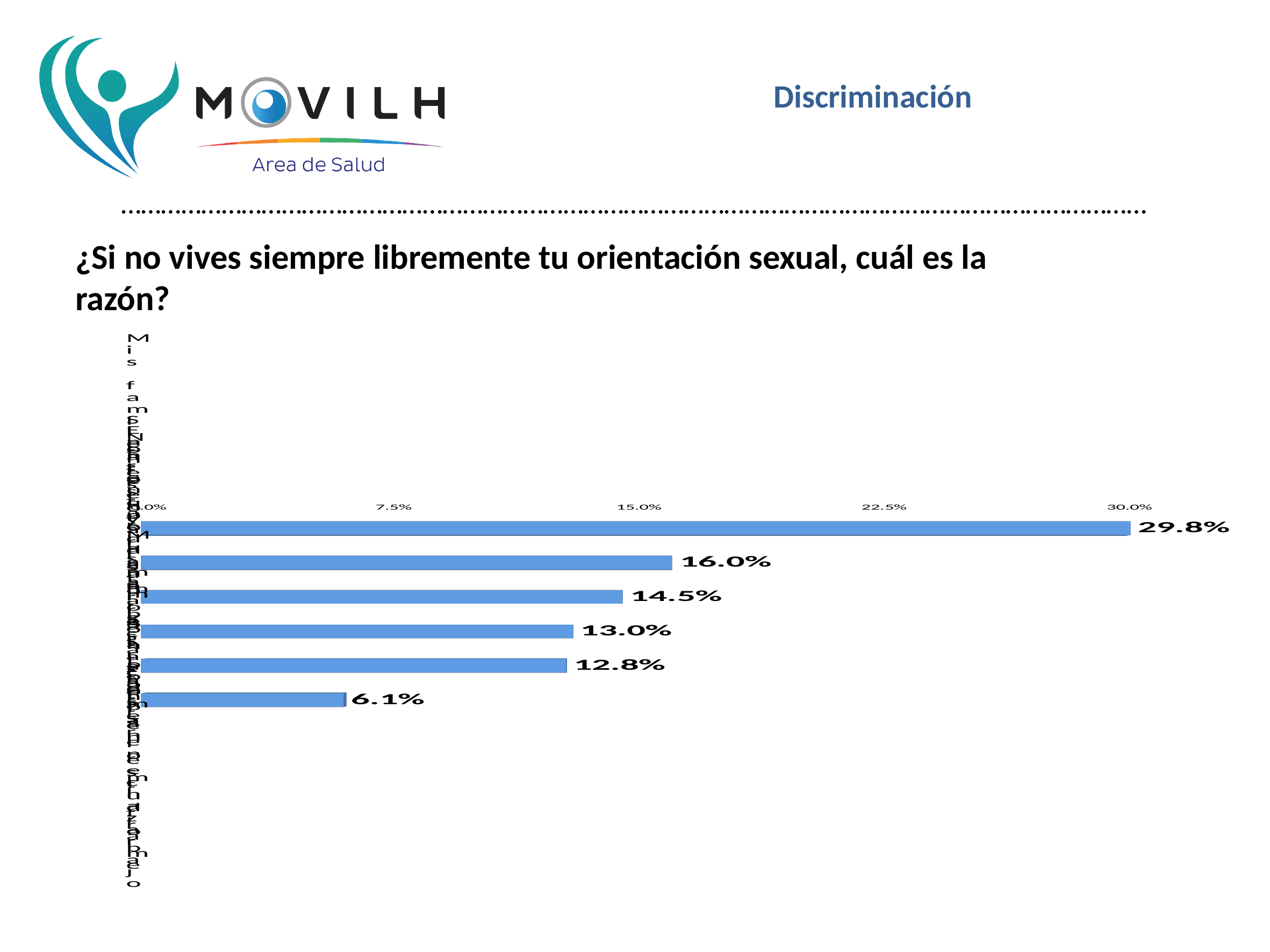
What kind of chart is shown on the slide? bar chart What is the difference between the fourth bar (13.0%) and the fifth bar (12.8%)? 0.2% Is the value of the top bar greater or less than 22.5%? greater What is the value of the shortest bar in the chart? 6.1% What is the value shown on the top bar of the chart? 29.8% What is the difference between the top bar (29.8%) and the second bar (16.0%)? 13.8% What is the value shown on the second bar from the top? 16.0% Do the bar values increase or decrease from the top of the chart to the bottom? decrease What is the value shown on the bottom bar of the chart? 6.1% What is the value of the longest bar in the chart? 29.8% How many bars does the chart show? 6 Which is larger, the third bar from the top or the bottom bar? the third bar from the top